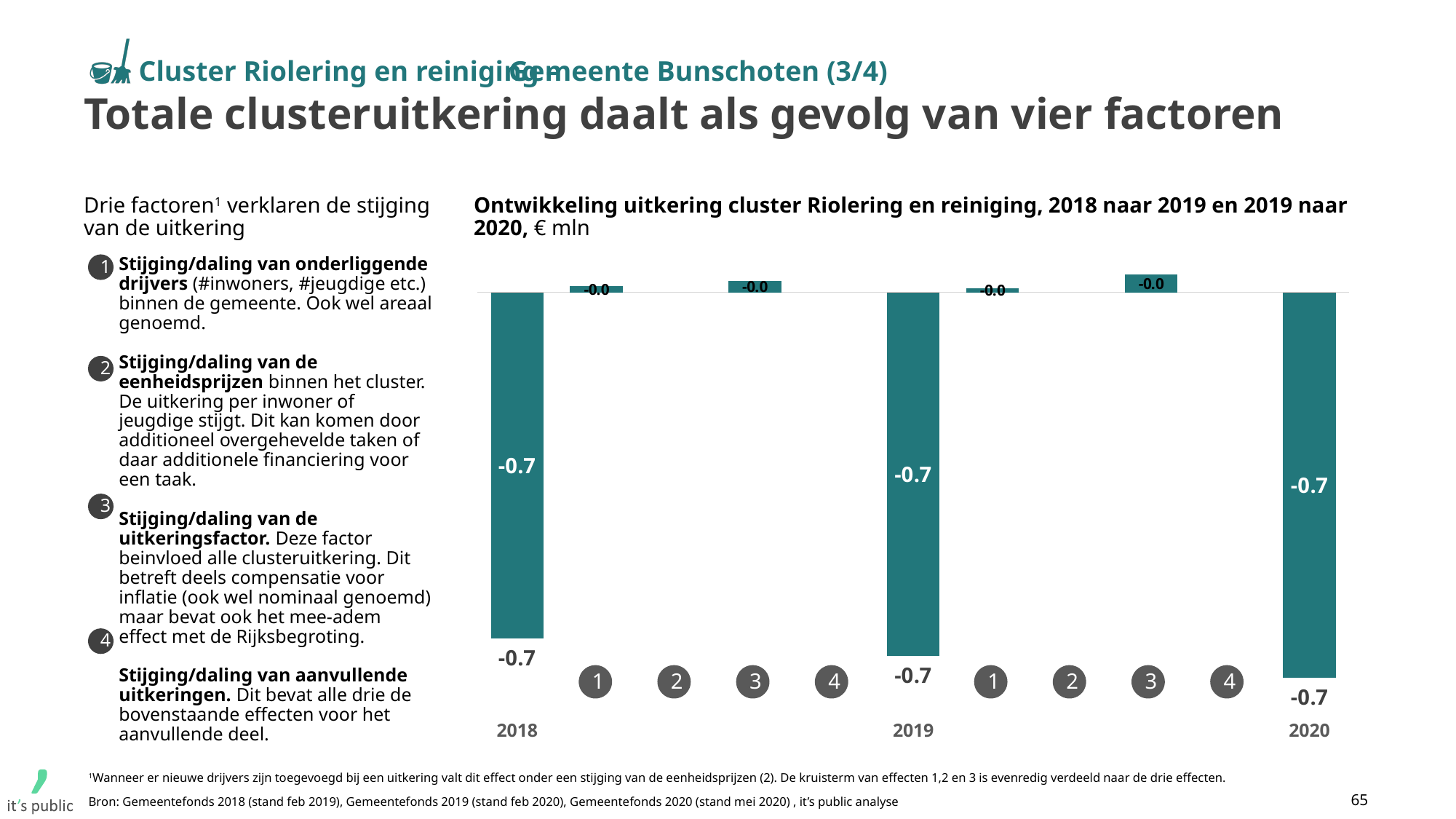
What value is labelled on factor 3 between 2019 and 2020? -0.0 How many numbered factor bars are shown between 2018 and 2019? 4 What is the value shown for the 2018 bar? -0.7 What kind of chart is shown on the slide? Bar chart What is the value shown for the 2020 bar? -0.7 What is the title of the chart? Ontwikkeling uitkering cluster Riolering en reiniging, 2018 naar 2019 en 2019 naar 2020, € mln What is the difference between the 2018 value and the 2020 value? 0.0 Does the total value rise, fall or stay the same from 2018 to 2020? Falls In what unit are the chart values expressed, according to the chart title? € mln What value is labelled on factor 1 between 2018 and 2019? -0.0 How many year totals (2018, 2019, 2020) are shown in the chart? 3 What is the value shown for the 2019 bar? -0.7